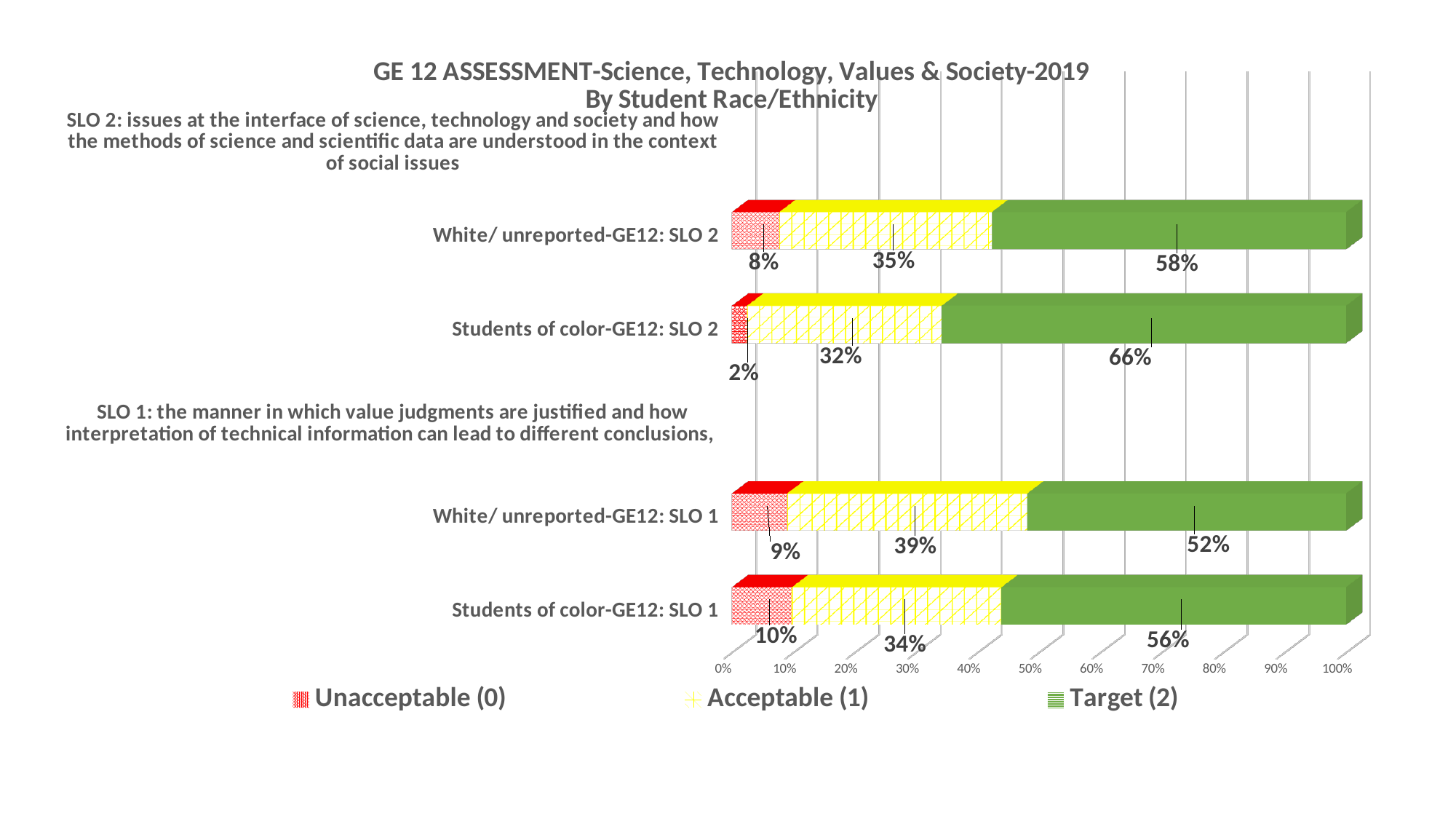
What is the title of the chart? GE 12 ASSESSMENT-Science, Technology, Values & Society-2019 By Student Race/Ethnicity What is the Unacceptable (0) value for White/ unreported-GE12: SLO 1? 9% What is the difference between the Target (2) values for Students of color-GE12: SLO 2 and White/ unreported-GE12: SLO 2? 8% What is the Target (2) value for Students of color-GE12: SLO 2? 66% How many categories (bars) are plotted in the chart? 4 What is the Acceptable (1) value for Students of color-GE12: SLO 1? 34% What is the total of the stacked bar for Students of color-GE12: SLO 1? 100% Which category has the lowest Unacceptable (0) value? Students of color-GE12: SLO 2 Which is larger, the Acceptable (1) value for White/ unreported-GE12: SLO 1 or for Students of color-GE12: SLO 1? White/ unreported-GE12: SLO 1 Which category has the highest Target (2) value? Students of color-GE12: SLO 2 How many series does the legend list? 3 What kind of chart is shown on the slide? Stacked bar chart